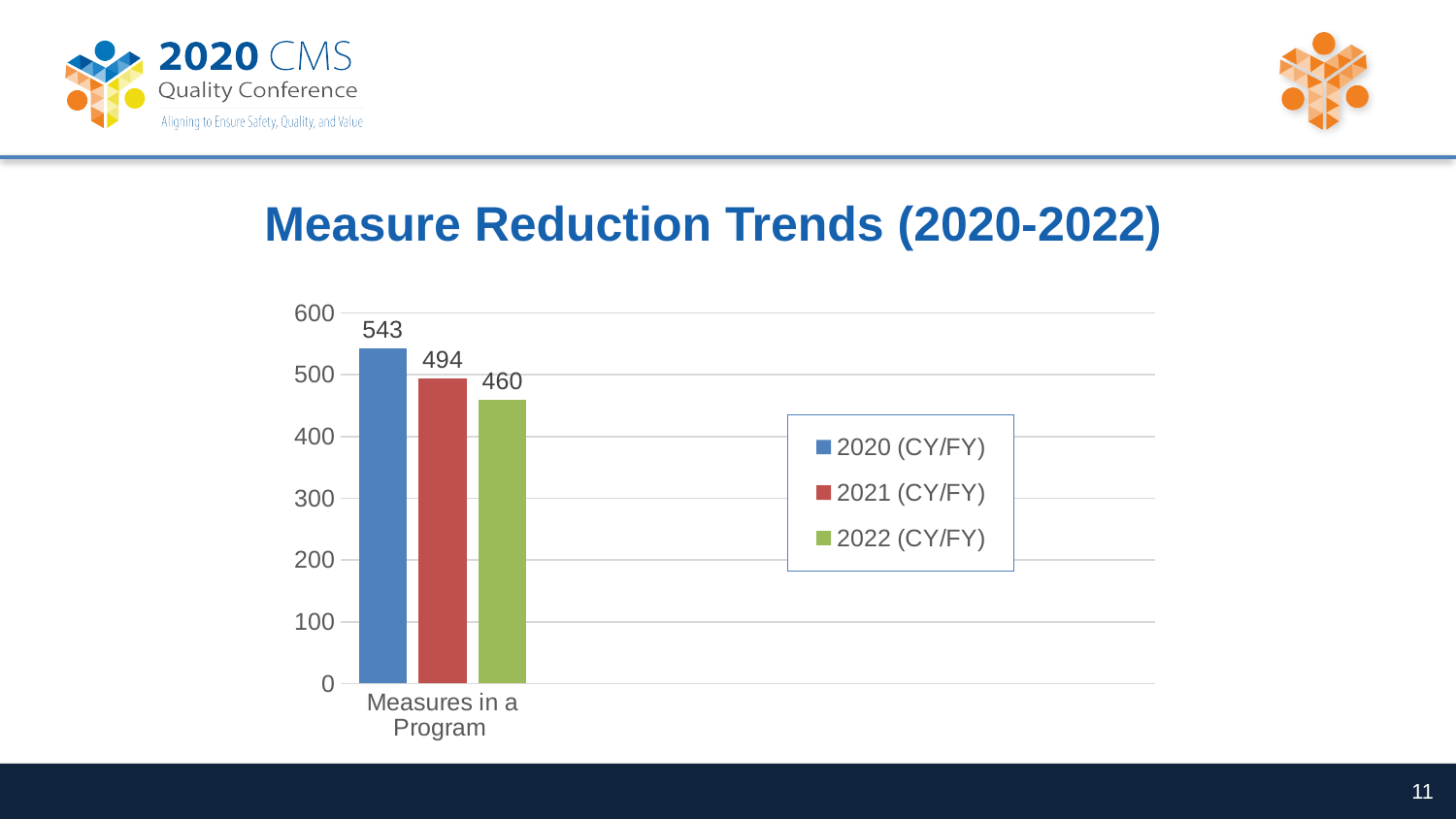
How many series does the legend list? 3 What is the difference between the 2020 (CY/FY) and 2021 (CY/FY) values? 49 What is the value for 2021 (CY/FY) for Measures in a Program? 494 What is the difference between the 2020 (CY/FY) and 2022 (CY/FY) values? 83 What kind of chart is shown on the slide? bar chart What is the value for 2022 (CY/FY) for Measures in a Program? 460 What is the value for 2020 (CY/FY) for Measures in a Program? 543 Which series has the highest value for Measures in a Program? 2020 (CY/FY) Is the value for 2022 (CY/FY) greater or less than 500? less Do the values rise or fall from 2020 (CY/FY) to 2022 (CY/FY)? fall Which is larger, the 2021 (CY/FY) value or the 2022 (CY/FY) value? 2021 (CY/FY) Which series has the lowest value for Measures in a Program? 2022 (CY/FY)